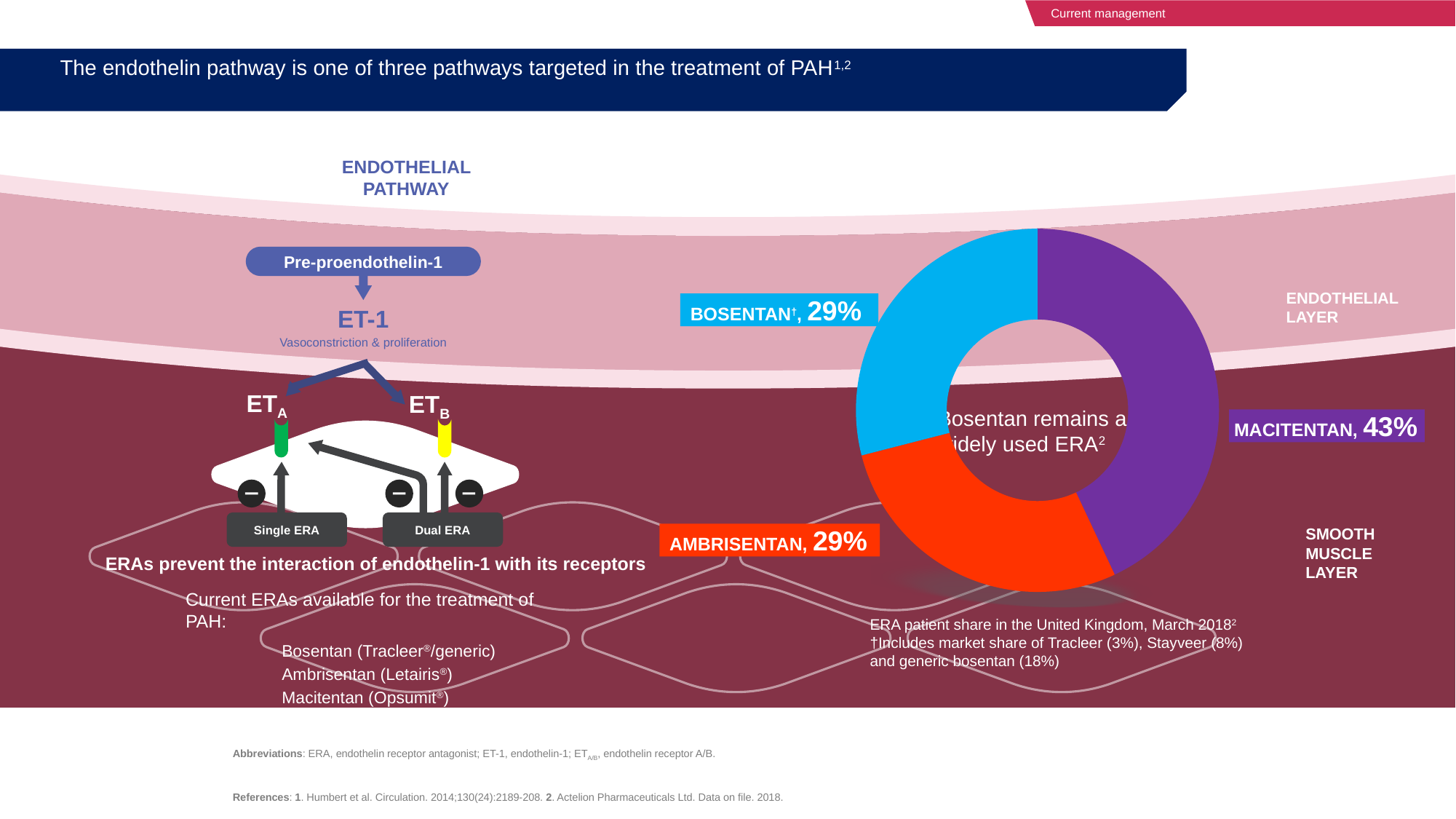
How many ERAs (slices) are shown in the donut chart? 3 What colour is the Macitentan slice in the donut chart? Purple What is the patient share for Ambrisentan in the donut chart? 29% Which ERA has the largest share in the donut chart? Macitentan Do Bosentan and Ambrisentan have the same share in the donut chart? Yes, both 29% What country and date does the ERA patient share chart refer to? United Kingdom, March 2018 What is the patient share for Macitentan in the donut chart? 43% Which has the larger share in the donut chart, Macitentan or Bosentan? Macitentan By how many percentage points does Macitentan's share exceed Ambrisentan's share? 14 percentage points What is the patient share for Bosentan in the donut chart? 29% What kind of chart is used to show ERA patient share? Donut (pie) chart